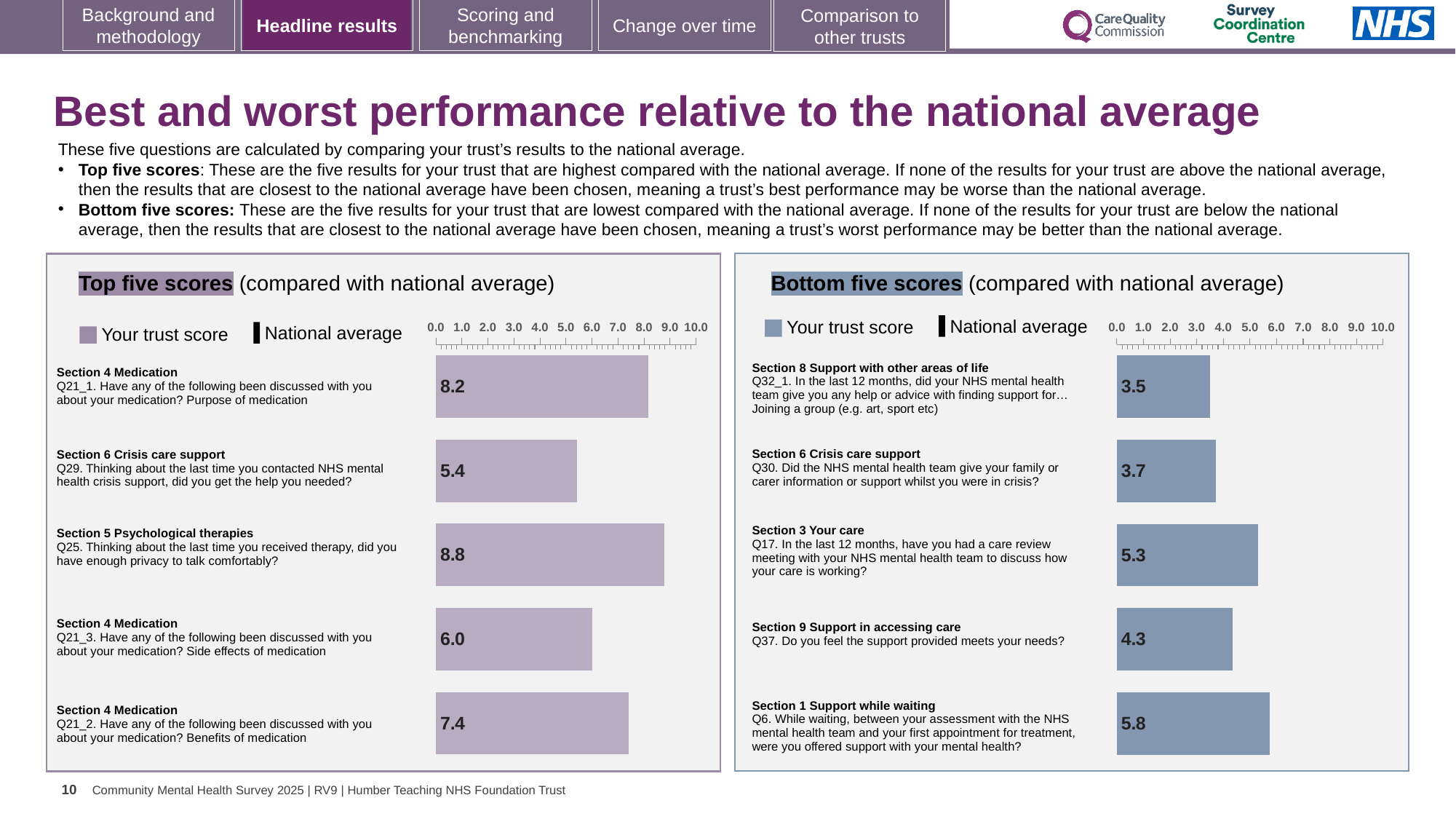
How many questions are plotted in the Bottom five scores chart? 5 In the Top five scores chart, is the trust score for Q21_2 greater or less than 7.0? greater What type of chart is the Top five scores chart? bar chart In the Top five scores chart, what is the difference between the trust scores for Q21_1 and Q29? 2.8 In the Top five scores chart, which question has the lowest trust score? Q29 (Section 6 Crisis care support) In the Top five scores chart, what is the trust score for Q25 (Section 5 Psychological therapies)? 8.8 How many entries does the legend of the Bottom five scores chart list? 2 In the Bottom five scores chart, what is the trust score for Q37 (Section 9 Support in accessing care)? 4.3 In the Bottom five scores chart, what is the difference between the trust scores for Q6 and Q32_1? 2.3 In the Top five scores chart, which question has the highest trust score? Q25 (Section 5 Psychological therapies) In the Bottom five scores chart, which has the larger trust score: Q17 or Q6? Q6 In the Bottom five scores chart, which question has the lowest trust score? Q32_1 (Section 8 Support with other areas of life)